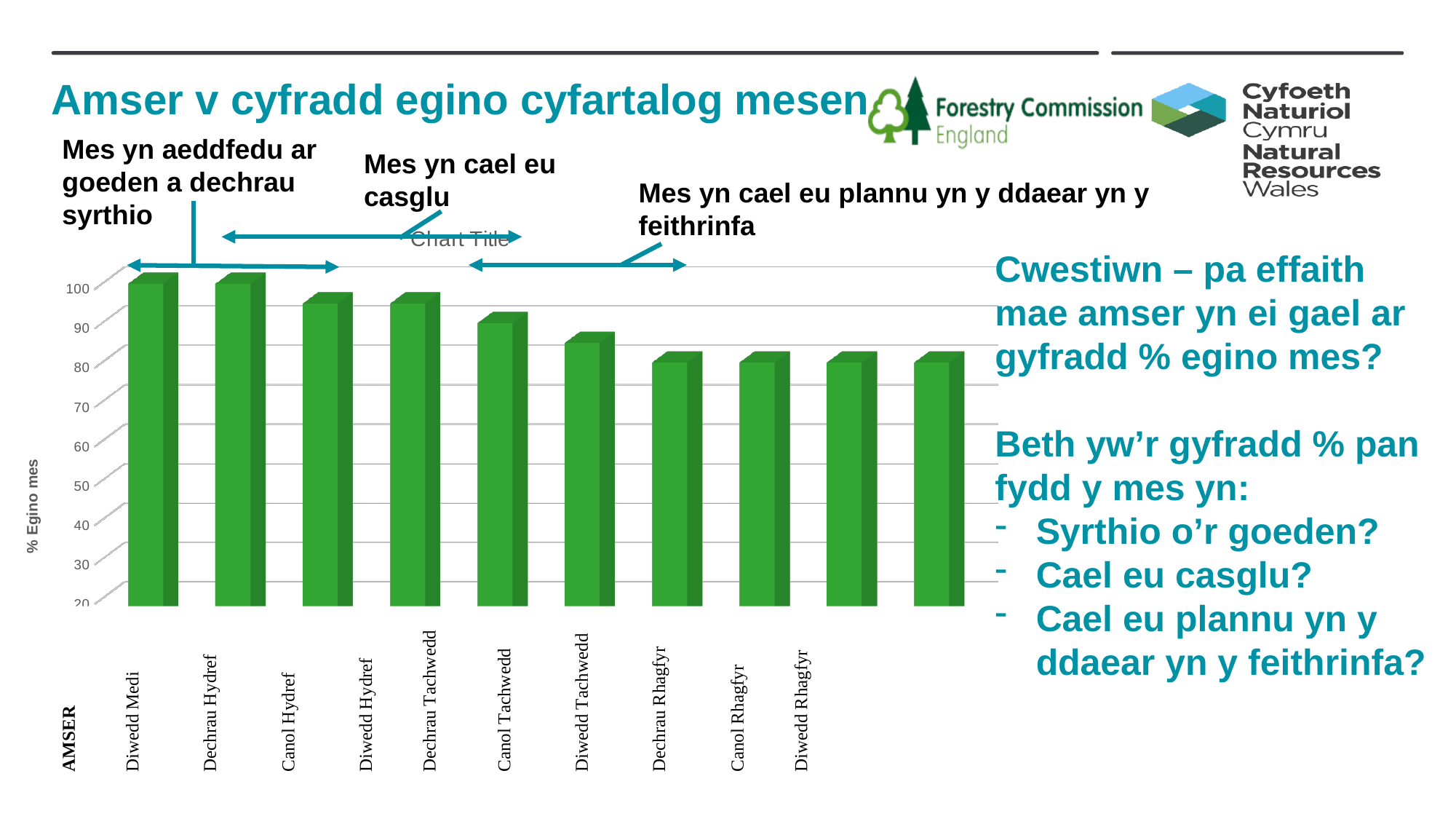
Is the value for Diwedd Tachwedd greater or less than 90? less Do the values rise or fall moving from Diwedd Medi to Diwedd Rhagfyr along the x axis? fall Which is larger, the value for Canol Tachwedd or the value for Dechrau Rhagfyr? Canol Tachwedd Is the value for Canol Tachwedd greater or less than 80? greater Which is larger, the value for Diwedd Medi or the value for Diwedd Rhagfyr? Diwedd Medi Is the value for Canol Hydref greater or less than 80? greater What is the label on the vertical axis of the chart? % Egino mes What is the label on the horizontal axis of the chart? AMSER How many categories are plotted along the x axis of the chart? 10 What kind of chart is shown on the slide? bar chart